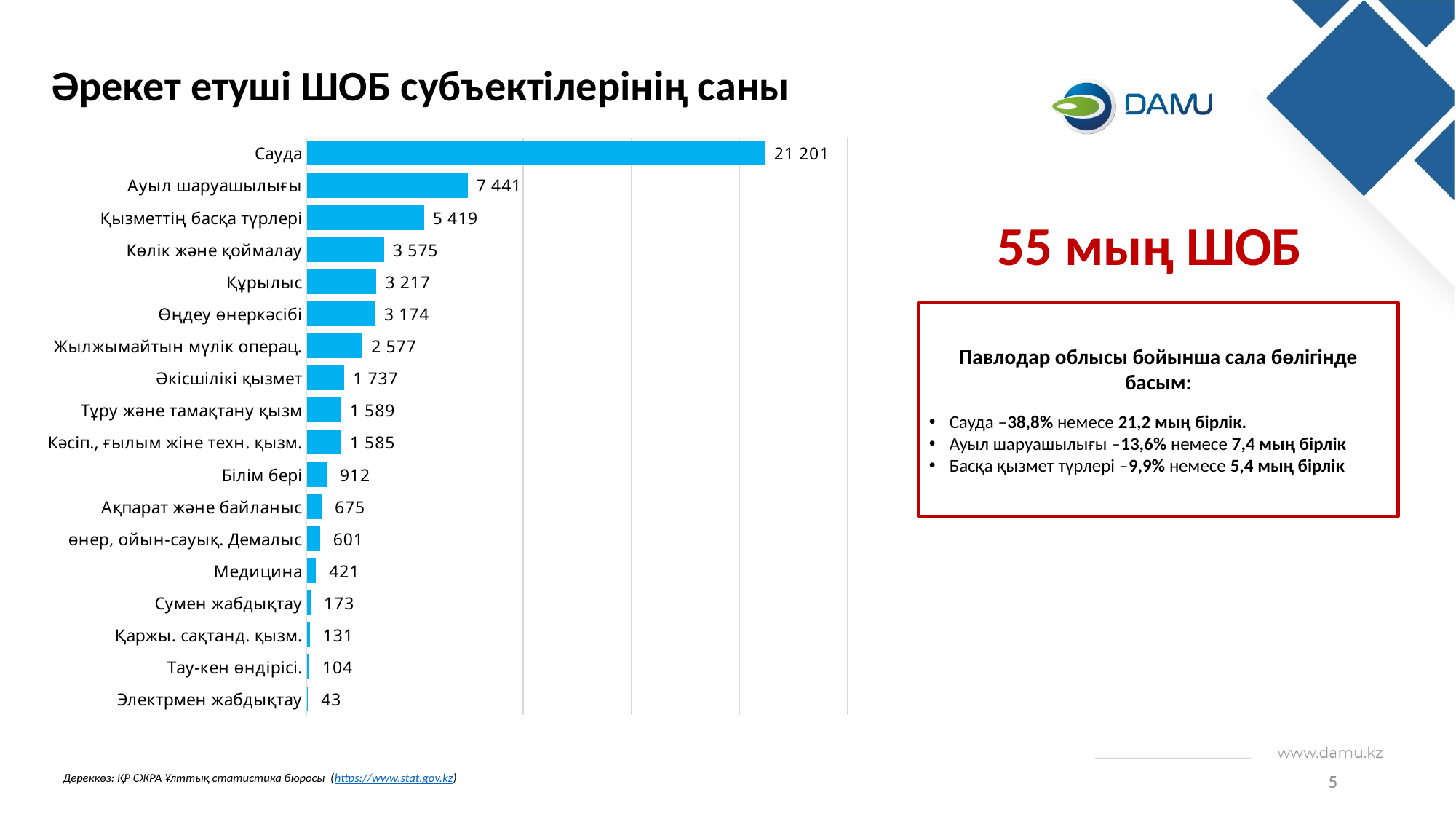
What type of chart is shown on the slide? bar chart Which category has the lowest value? Электрмен жабдықтау What is the value for Медицина? 421 Which is larger, the value for Білім бері or the value for Ақпарат және байланыс? Білім бері What is the title of the chart? Әрекет етуші ШОБ субъектілерінің саны What is the value for Ауыл шаруашылығы? 7 441 How many categories are shown in the chart? 18 What is the value for Құрылыс? 3 217 What is the difference between the values for Көлік және қоймалау and Құрылыс? 358 What is the value for Сауда? 21 201 What is the difference between the values for Сауда and Ауыл шаруашылығы? 13 760 Which category has the highest value? Сауда